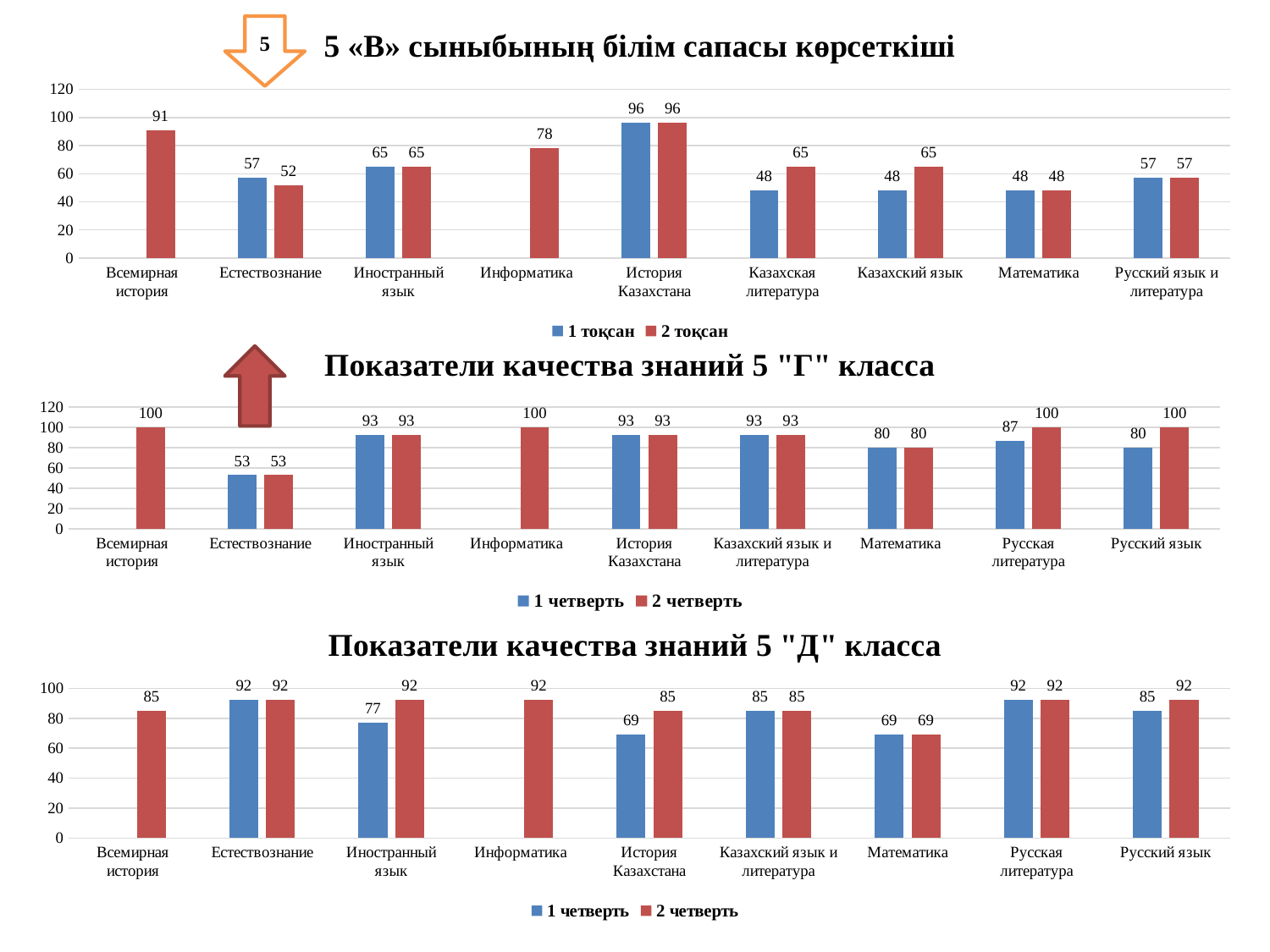
In the chart titled '5 «В» сыныбының білім сапасы көрсеткіші', what is the value for Информатика in 2 тоқсан? 78 In the chart titled '5 «В» сыныбының білім сапасы көрсеткіші', which subject has the highest value in 1 тоқсан? История Казахстана In the chart titled 'Показатели качества знаний 5 "Д" класса', what are the two legend entries? 1 четверть, 2 четверть In the chart titled '5 «В» сыныбының білім сапасы көрсеткіші', how many subjects are shown on the x axis? 9 In the chart titled 'Показатели качества знаний 5 "Г" класса', is the 1 четверть value for Математика larger or smaller than the 1 четверть value for Иностранный язык? smaller What kind of chart is 'Показатели качества знаний 5 "Д" класса'? bar chart In the chart titled 'Показатели качества знаний 5 "Г" класса', which subject has the lowest value in 2 четверть? Естествознание In the chart titled 'Показатели качества знаний 5 "Г" класса', what is the value for Русская литература in 1 четверть? 87 In the chart titled 'Показатели качества знаний 5 "Д" класса', what is the value for История Казахстана in 1 четверть? 69 In the chart titled 'Показатели качества знаний 5 "Г" класса', how many series does the legend list? 2 In the chart titled '5 «В» сыныбының білім сапасы көрсеткіші', what is the difference between the 2 тоқсан and 1 тоқсан values for Казахская литература? 17 In the chart titled 'Показатели качества знаний 5 "Д" класса', what is the difference between the 2 четверть and 1 четверть values for Иностранный язык? 15